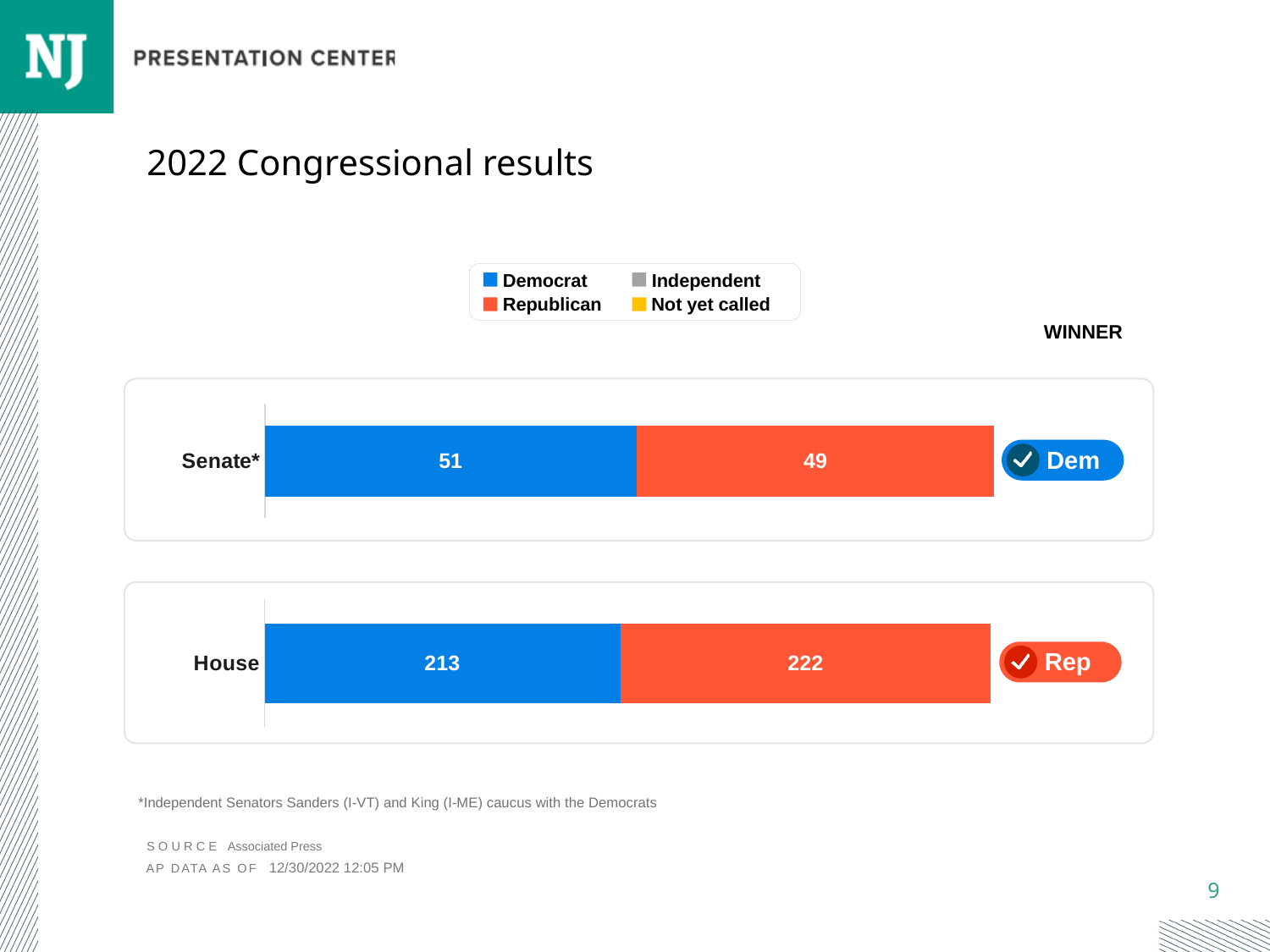
What kind of chart is shown on the slide? Stacked bar chart What is the Republican value for the Senate* bar? 49 What is the Democrat value for the Senate* bar? 51 How many categories (bars) are shown in the chart? 2 How many series does the legend list? 4 Which party is marked as the winner for the House? Rep What is the total of the House stacked bar? 435 What is the difference between the Republican and Democrat values in the House bar? 9 In the Senate* bar, which is larger, the Democrat value or the Republican value? Democrat What is the Republican value for the House bar? 222 What is the Democrat value for the House bar? 213 What is the total of the Senate* stacked bar? 100